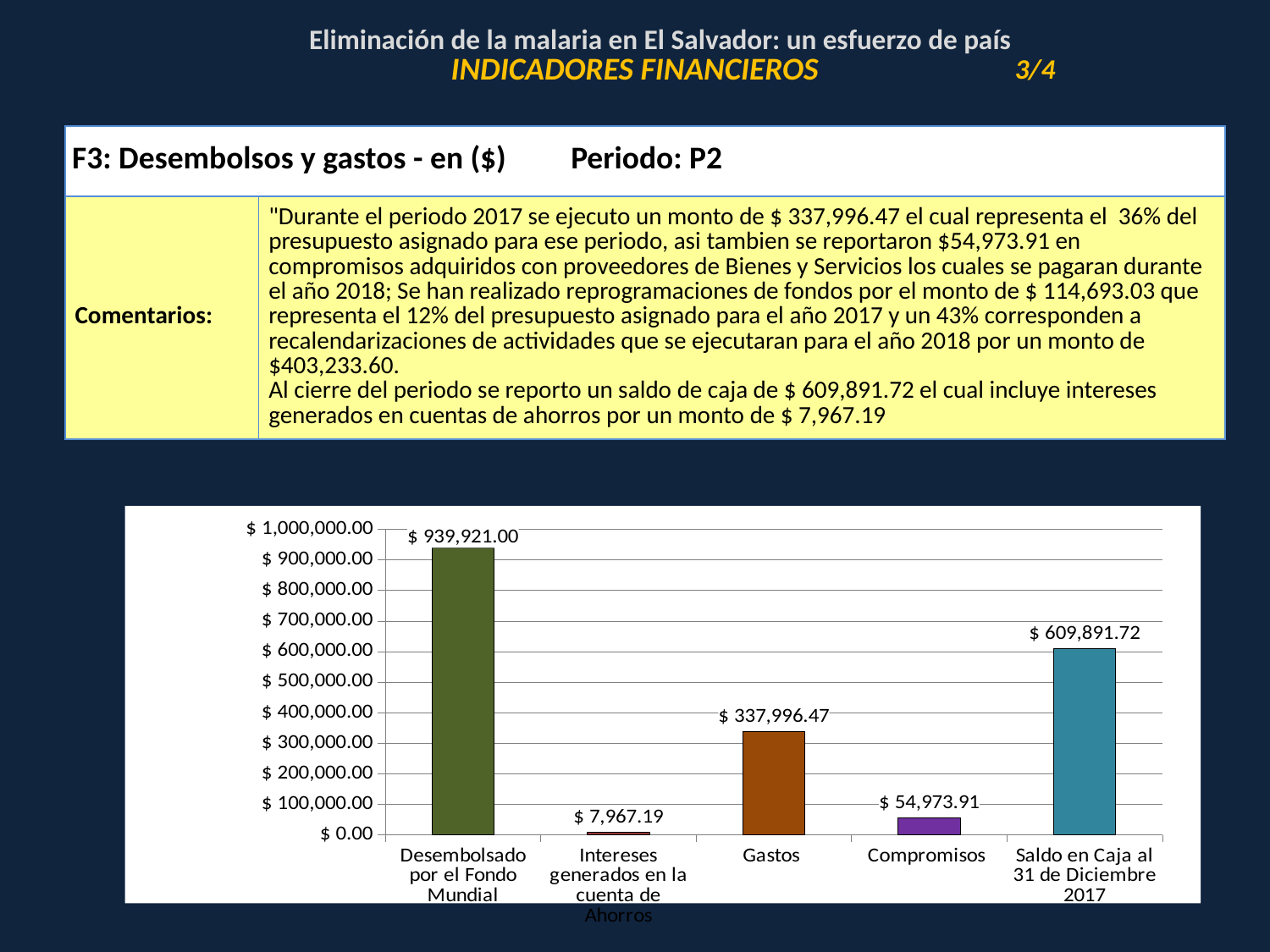
What is the value for Desembolsado por el Fondo Mundial? $ 939,921.00 Which category has the highest value? Desembolsado por el Fondo Mundial What is the value for Gastos? $ 337,996.47 Which category has the lowest value? Intereses generados en la cuenta de Ahorros What is the value for Intereses generados en la cuenta de Ahorros? $ 7,967.19 What kind of chart is shown on the slide? Bar chart What is the value for Saldo en Caja al 31 de Diciembre 2017? $ 609,891.72 How many categories are shown in the chart? 5 What is the difference between Gastos and Compromisos? $ 283,022.56 Which is larger, Saldo en Caja al 31 de Diciembre 2017 or Gastos? Saldo en Caja al 31 de Diciembre 2017 What is the difference between Desembolsado por el Fondo Mundial and Gastos? $ 601,924.53 What is the value for Compromisos? $ 54,973.91